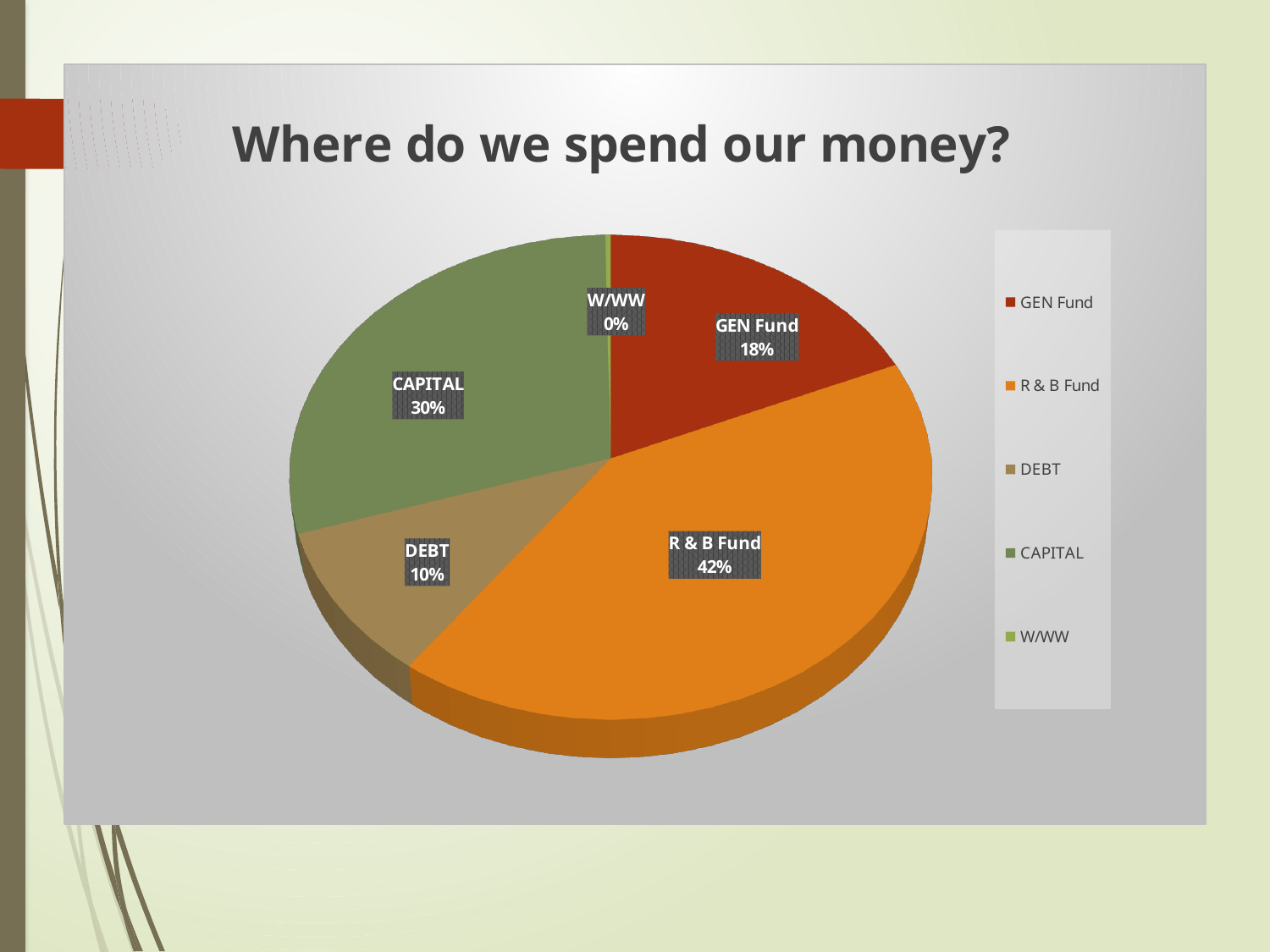
What kind of chart is shown on the slide? Pie chart Which category has the smallest slice of the pie? W/WW How many categories does the pie chart show? 5 Which is larger, the GEN Fund slice or the CAPITAL slice? CAPITAL What percentage is shown for W/WW? 0% What percentage is shown for DEBT? 10% What percentage is shown for CAPITAL? 30% What percentage is shown for the GEN Fund? 18% What is the title of the chart? Where do we spend our money? What share of spending goes to the R & B Fund? 42% What is the difference in percentage points between CAPITAL and DEBT? 20 Which category has the largest slice of the pie? R & B Fund